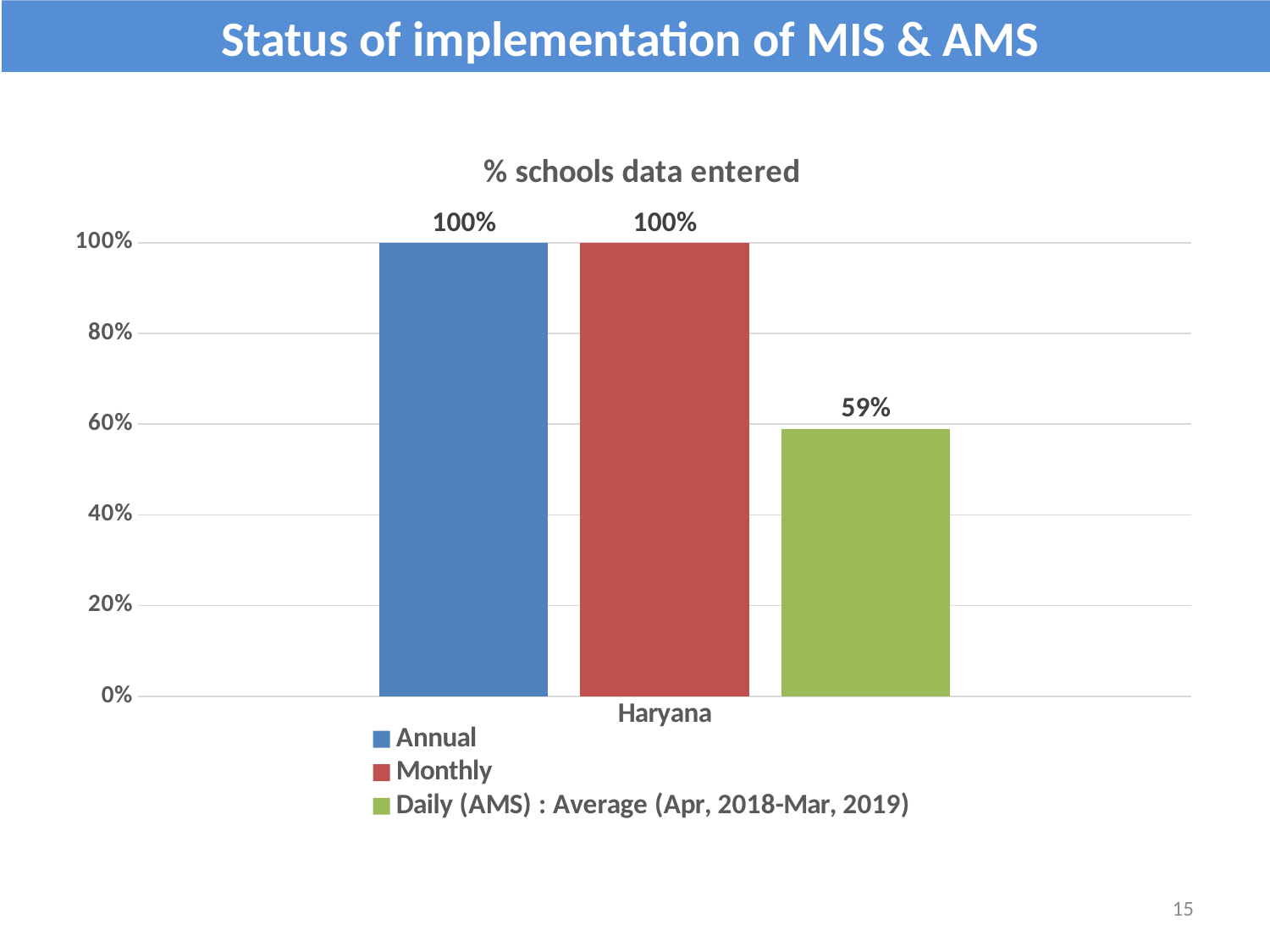
How many series does the legend list? 3 What colour is the bar for the Monthly series? red How many categories are shown on the x axis? 1 Which is larger for Haryana, the Monthly value or the Daily (AMS) value? Monthly What is the value of the Monthly series for Haryana? 100% What is the difference between the Annual value and the Daily (AMS) value for Haryana? 41% Is the Daily (AMS) value for Haryana greater or less than 60%? less What is the value of the Annual series for Haryana? 100% What kind of chart is shown on the slide? bar chart What is the value of the Daily (AMS) : Average (Apr, 2018-Mar, 2019) series for Haryana? 59% What is the title of the chart? % schools data entered Which series has the lowest value for Haryana? Daily (AMS) : Average (Apr, 2018-Mar, 2019)